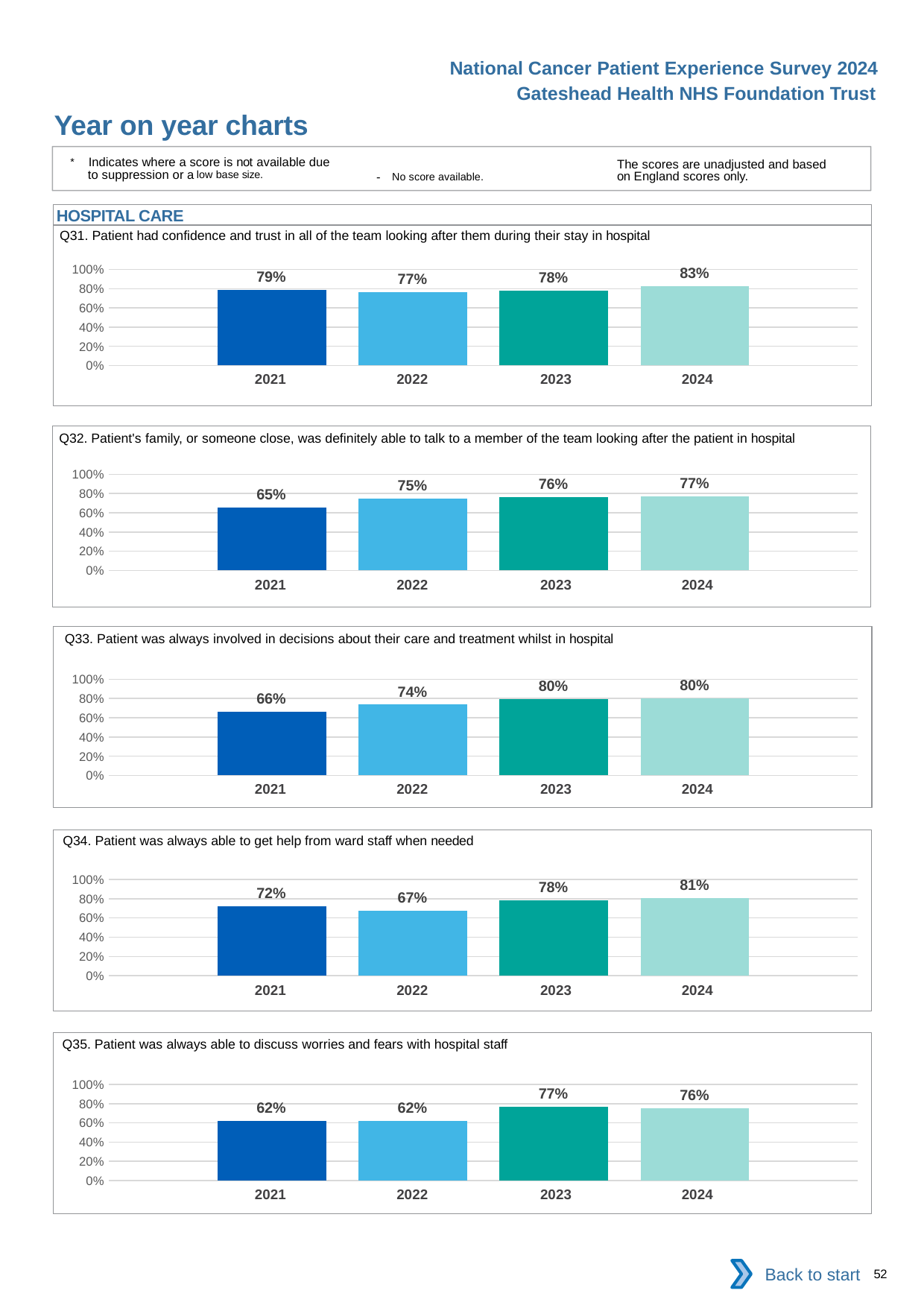
In the Q32 chart, what is the difference between the 2024 and 2021 values? 12% In the Q32 chart, what is the value for 2021? 65% In the Q34 chart, what is the difference between the 2021 and 2022 values? 5% In the Q33 chart, what is the value for 2023? 80% In the Q34 chart, which year has the highest value? 2024 What kind of chart is the Q31 chart? bar chart In the Q35 chart, is the value for 2023 greater or less than 60%? greater How many years are shown on the x axis of the Q34 chart? 4 In the Q35 chart, what is the value for 2022? 62% In the Q31 chart, which year has the lowest value? 2022 In the Q31 chart, what is the value for 2024? 83% In the Q33 chart, which is larger, the value for 2021 or the value for 2022? 2022